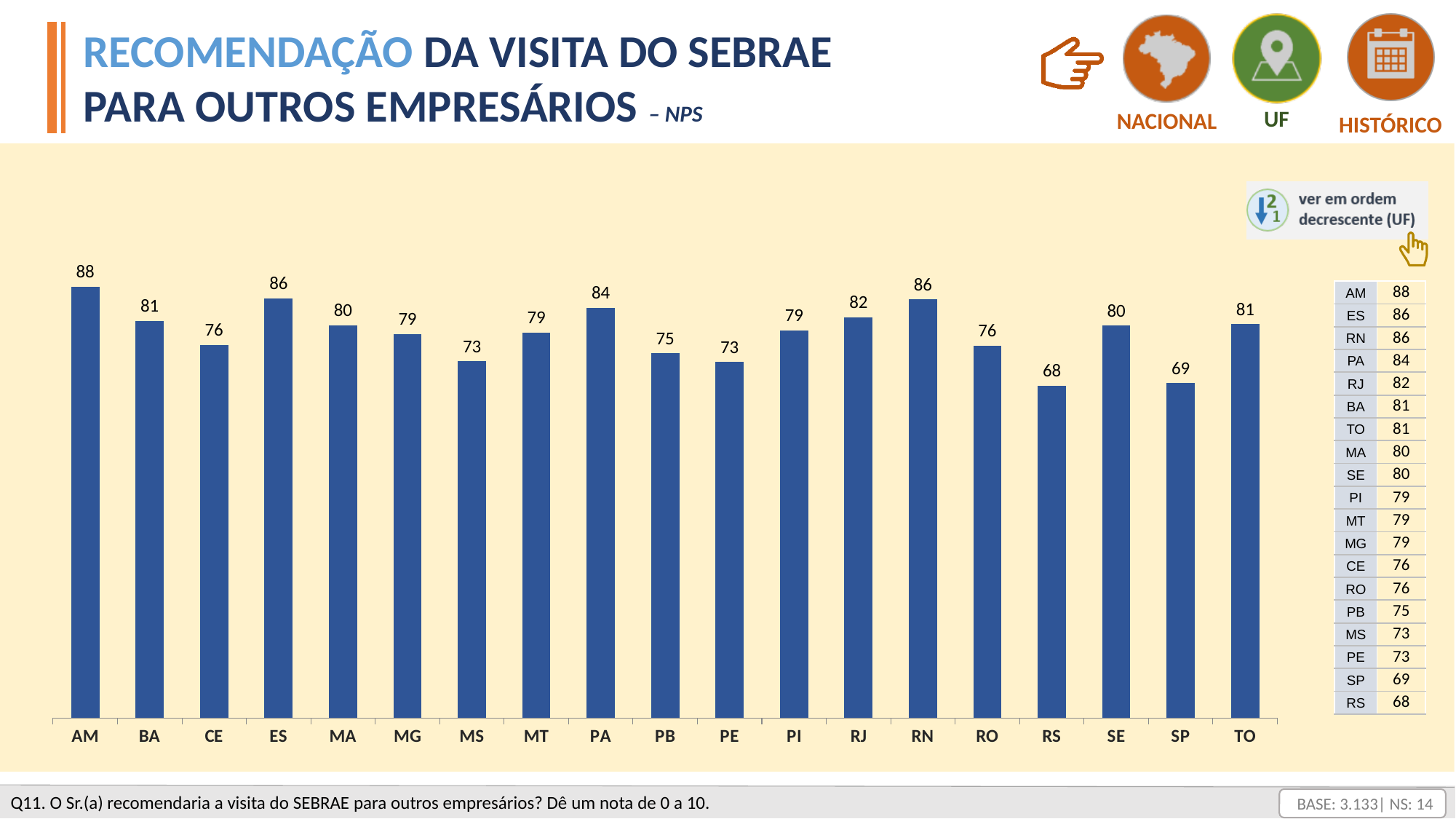
Which UF has the lowest NPS value? RS What is the NPS value for RS? 68 What is the difference between the NPS values for AM and RS? 20 What is the NPS value for TO? 81 What is the NPS value for PA? 84 What kind of chart is shown on the slide? bar chart How many UFs are shown on the x axis of the chart? 19 What is the difference between the NPS values for ES and CE? 10 What is the NPS value for AM? 88 Which UF has the highest NPS value? AM Which has a higher NPS value, RJ or SP? RJ Which has a higher NPS value, MS or MA? MA